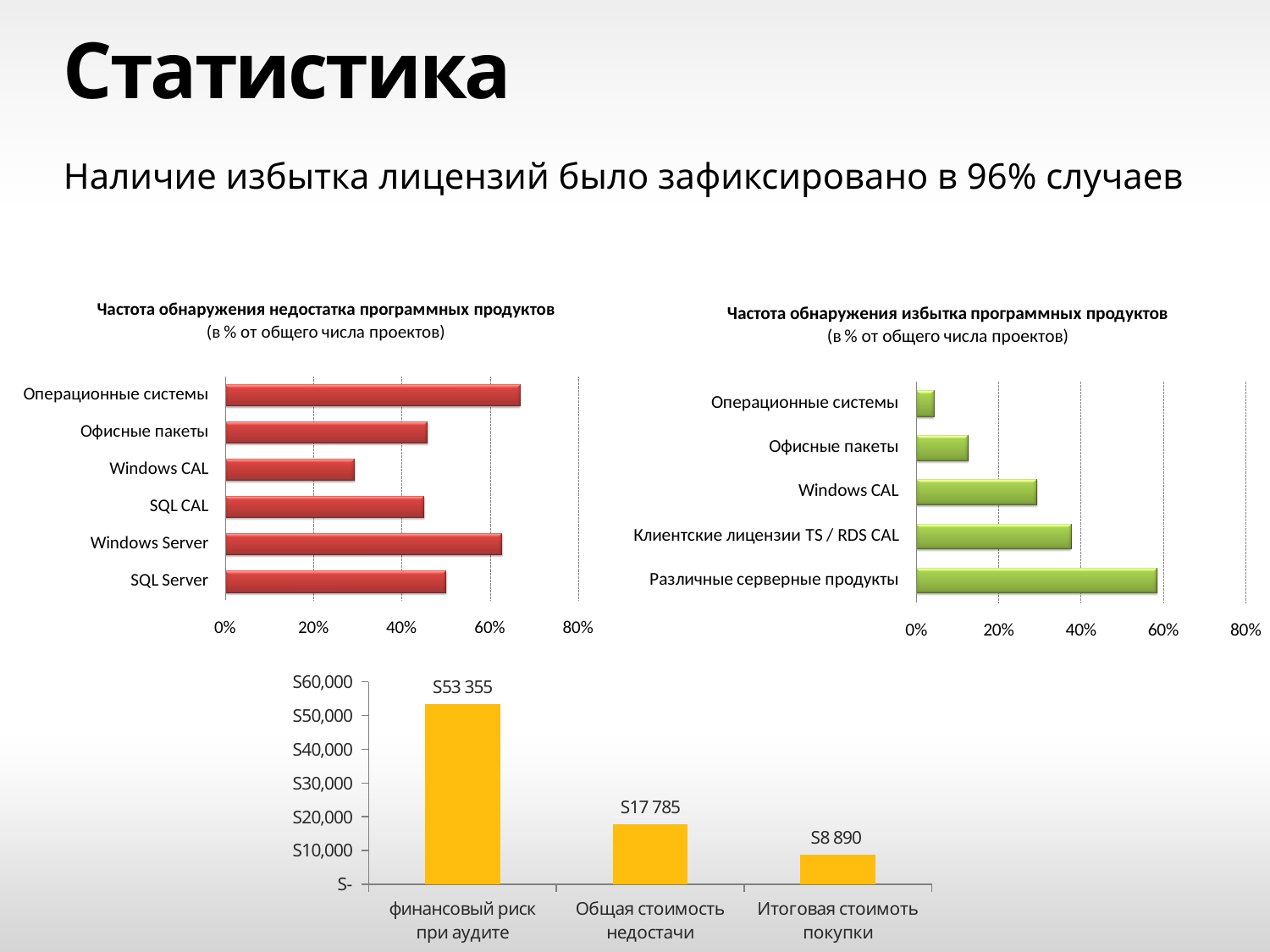
In the chart titled 'Частота обнаружения избытка программных продуктов', which is larger: Windows CAL or Клиентские лицензии TS / RDS CAL? Клиентские лицензии TS / RDS CAL In the chart titled 'Частота обнаружения недостатка программных продуктов', is the value for Windows Server greater or less than 60%? greater In the chart titled 'Частота обнаружения избытка программных продуктов', is the value for Офисные пакеты greater or less than 20%? less In the chart titled 'Частота обнаружения недостатка программных продуктов', which category has the lowest value? Windows CAL In the bottom chart, which category has the lowest value? Итоговая стоимоть покупки In the bottom chart, what is the value for финансовый риск при аудите? $53 355 What type of chart is the bottom chart? Bar chart In the bottom chart, what is the value for Итоговая стоимоть покупки? $8 890 In the chart titled 'Частота обнаружения недостатка программных продуктов', which category has the highest value? Операционные системы How many categories are shown in the chart titled 'Частота обнаружения избытка программных продуктов'? 5 In the bottom chart, what is the difference between финансовый риск при аудите and Общая стоимость недостачи? $35 570 In the chart titled 'Частота обнаружения избытка программных продуктов', which category has the highest value? Различные серверные продукты